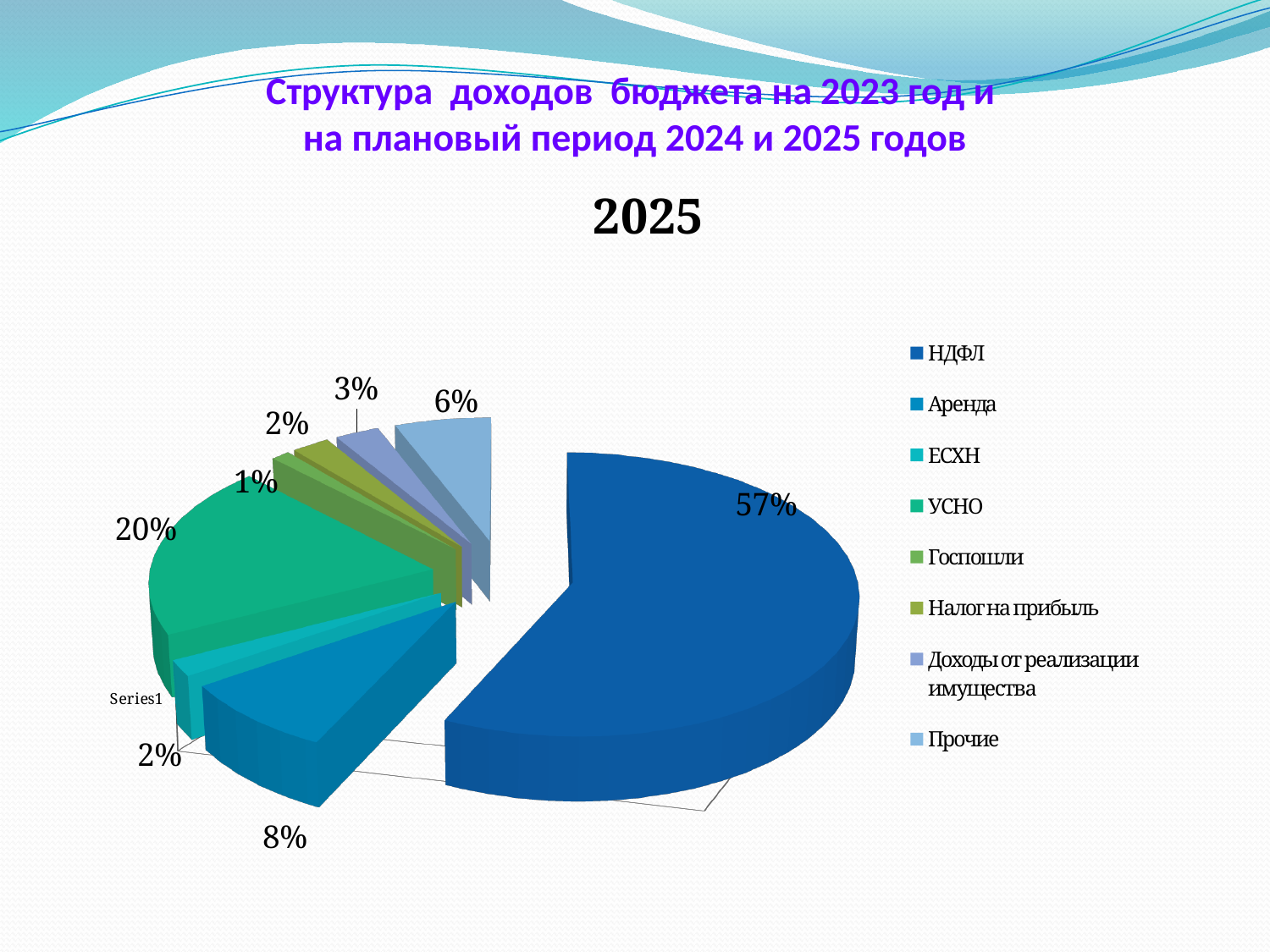
What is the chart's title? 2025 Which has a larger share, Аренда or Прочие? Аренда What share of the pie does УСНО have? 20% Which category has the largest share of the pie? НДФЛ Which category has the smallest share of the pie? Госпошли How many categories does the legend list? 8 What share of the pie does Доходы от реализации имущества have? 3% What is the difference between the shares of НДФЛ and УСНО? 37 percentage points What type of chart is shown on the slide? pie chart What share of the pie does Аренда have? 8%